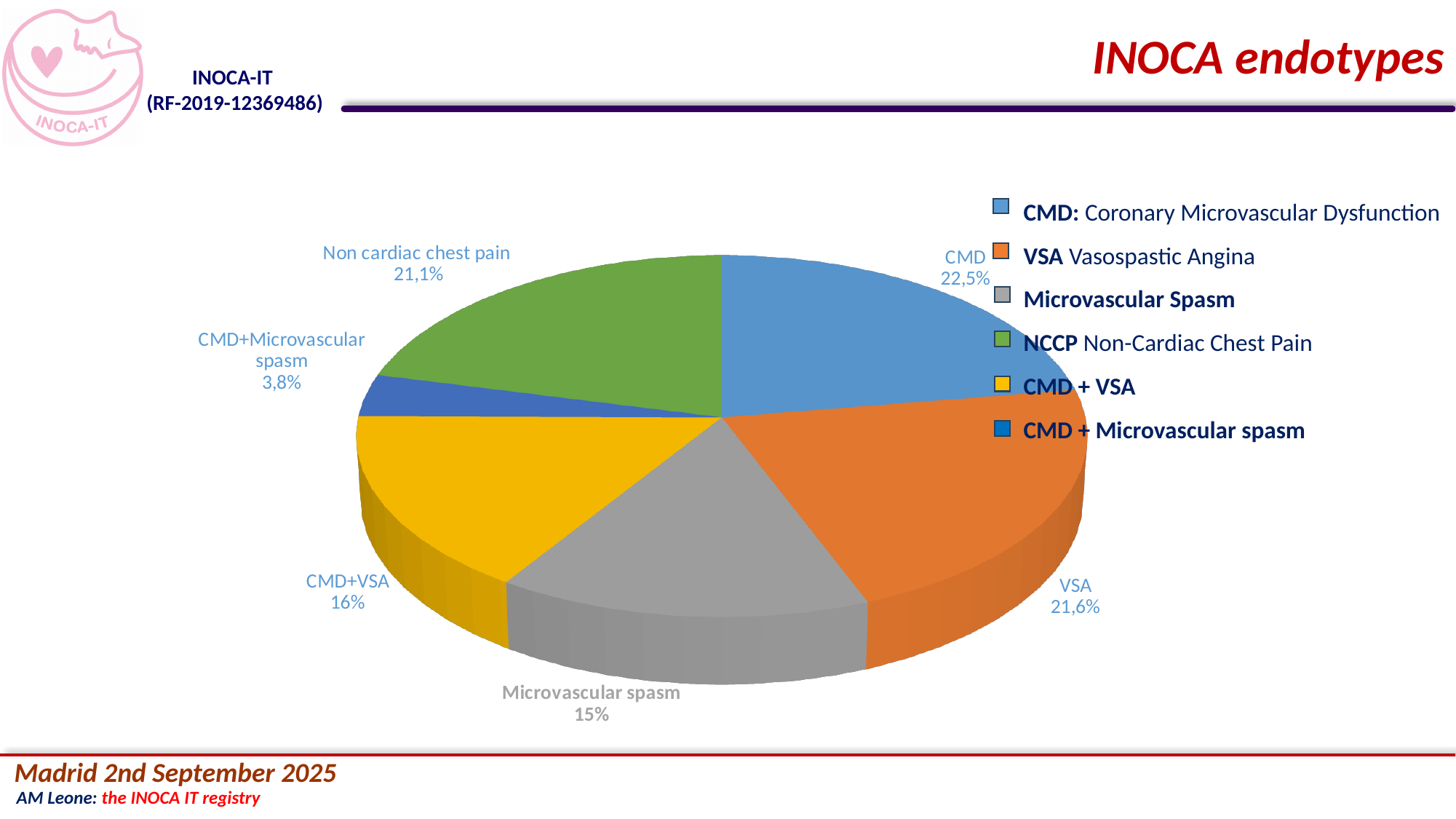
What percentage is shown for CMD+VSA? 16% What share of the pie is Non cardiac chest pain? 21,1% According to the legend, what does NCCP stand for? Non-Cardiac Chest Pain Which is larger, the CMD+VSA slice or the Microvascular spasm slice? CMD+VSA Which endotype has the largest slice of the pie? CMD What type of chart is shown on the slide? Pie chart What is the difference in percentage points between the CMD slice and the VSA slice? 0,9% How many slices does the pie chart have? 6 Which endotype has the smallest slice of the pie? CMD+Microvascular spasm What is the value shown for the Microvascular spasm slice? 15% What percentage of the pie does the CMD slice represent? 22,5% What is the value shown for the VSA slice? 21,6%